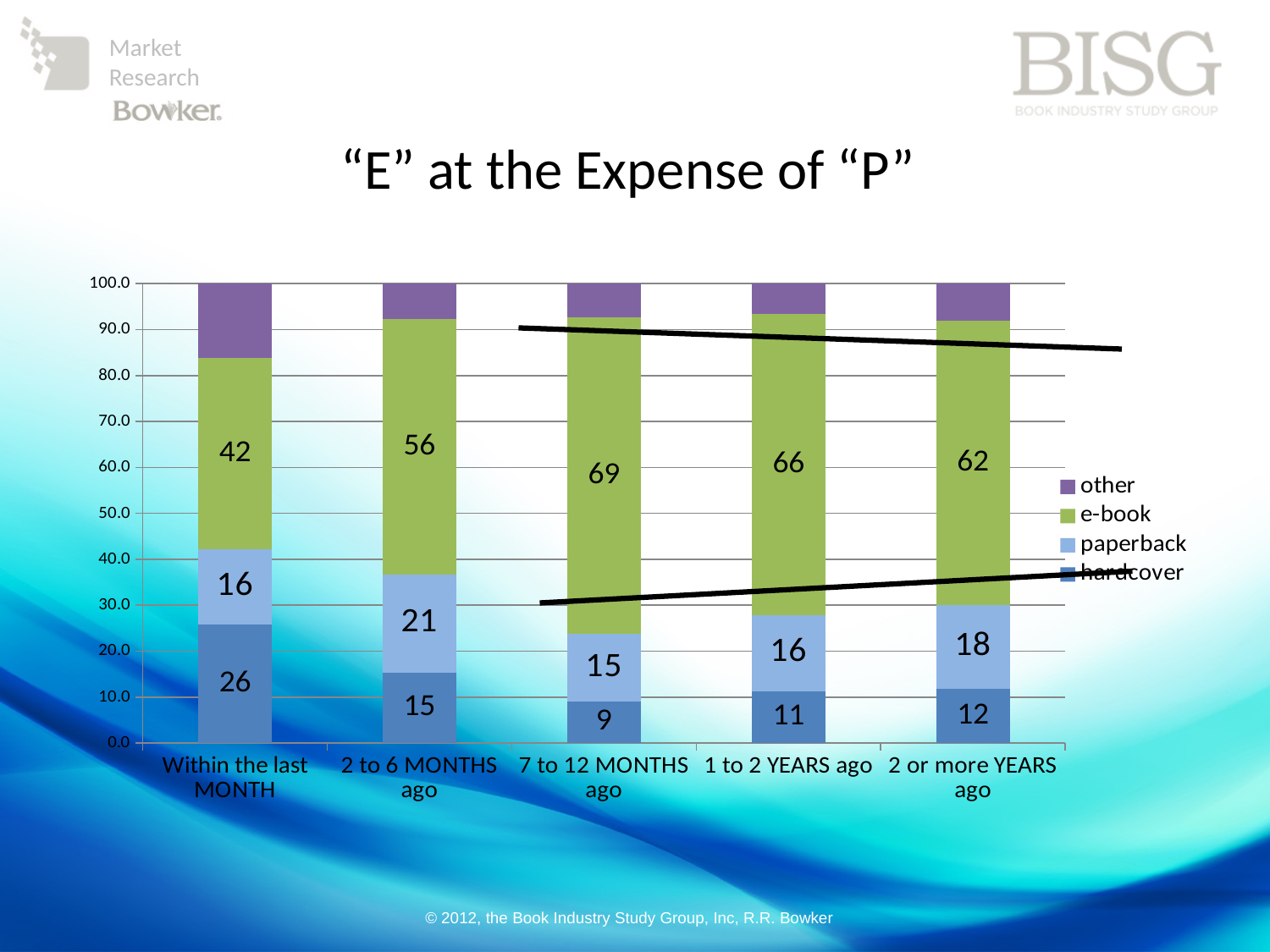
What is the paperback value for "2 to 6 MONTHS ago"? 21 How many categories are shown on the x axis? 5 What is the title of the slide? "E" at the Expense of "P" How many series does the legend list? 4 What kind of chart is shown on the slide? stacked bar chart Is the e-book value for "Within the last MONTH" greater or less than 50? less What is the difference between the e-book values for "2 to 6 MONTHS ago" and "Within the last MONTH"? 14 What is the hardcover value for "Within the last MONTH"? 26 Which category has the highest e-book value? 7 to 12 MONTHS ago What is the e-book value for "7 to 12 MONTHS ago"? 69 Which is larger: the paperback value for "2 or more YEARS ago" or for "1 to 2 YEARS ago"? 2 or more YEARS ago Which category has the lowest hardcover value? 7 to 12 MONTHS ago